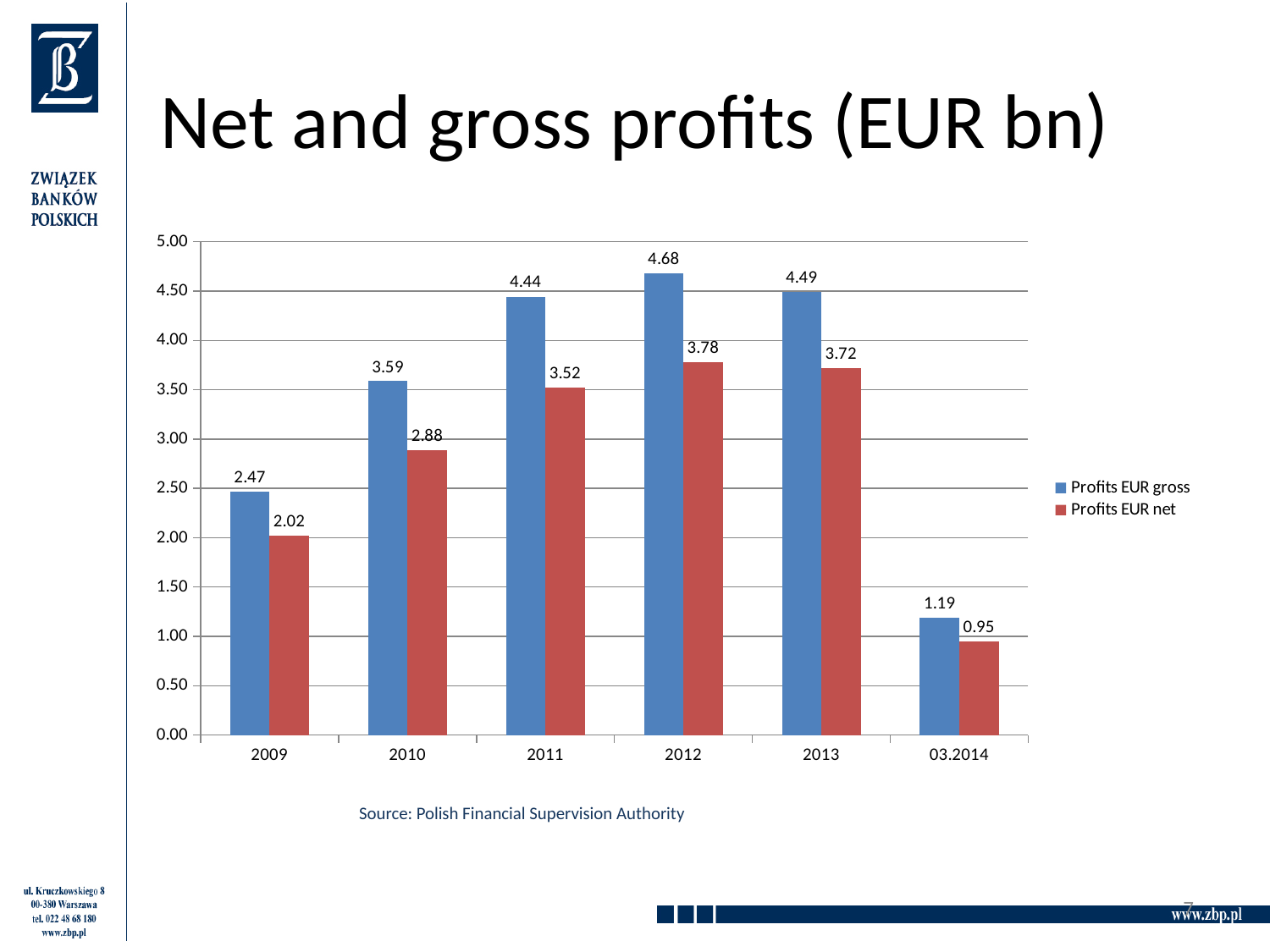
Which category has the lowest Profits EUR net? 03.2014 What is the value of Profits EUR gross for 2012? 4.68 How many categories are shown on the x axis? 6 What is the value of Profits EUR net for 03.2014? 0.95 Which year has the highest Profits EUR gross? 2012 Which is larger: Profits EUR gross in 2011 or Profits EUR gross in 2013? Profits EUR gross in 2013 What is the title of the chart? Net and gross profits (EUR bn) What is the difference between Profits EUR gross and Profits EUR net in 2013? 0.77 Is the value of Profits EUR net for 2009 greater or less than 2.50? less How many series does the legend list? 2 What kind of chart is shown on the slide? Bar chart What is the value of Profits EUR net for 2010? 2.88